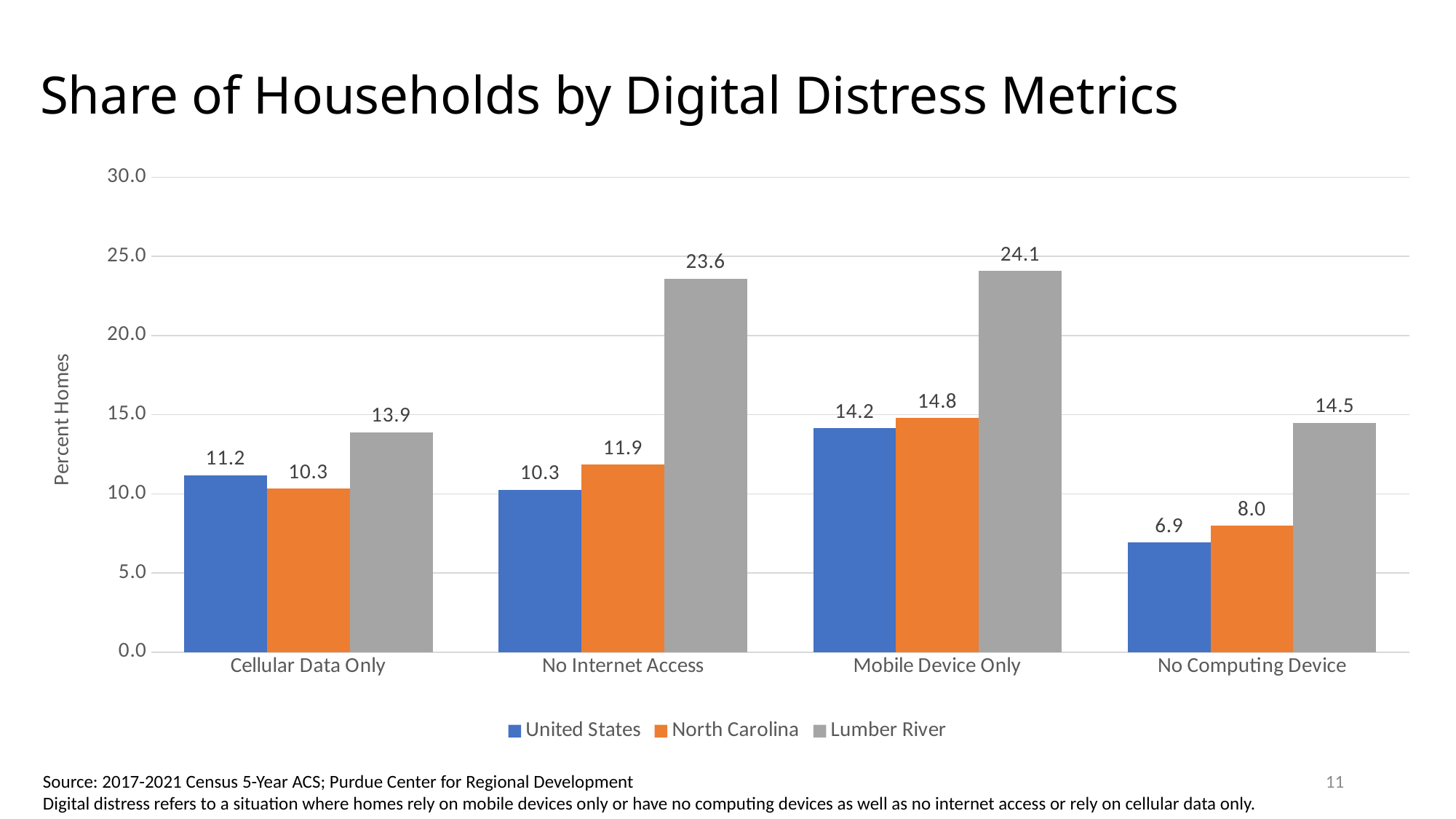
Which category has the lowest value for United States? No Computing Device What is the difference between the Lumber River and United States values in the Mobile Device Only category? 9.9 How many categories are shown on the x axis? 4 What is the value for North Carolina in the No Computing Device category? 8.0 Is the value for Lumber River in the No Computing Device category greater or less than 10.0? greater What kind of chart is shown on the slide? Bar chart How many series does the legend list? 3 Which is larger in the Cellular Data Only category: United States or North Carolina? United States Which category has the highest value for Lumber River? Mobile Device Only What is the value for United States in the Cellular Data Only category? 11.2 What is the value for Lumber River in the No Internet Access category? 23.6 What is the label of the y axis? Percent Homes